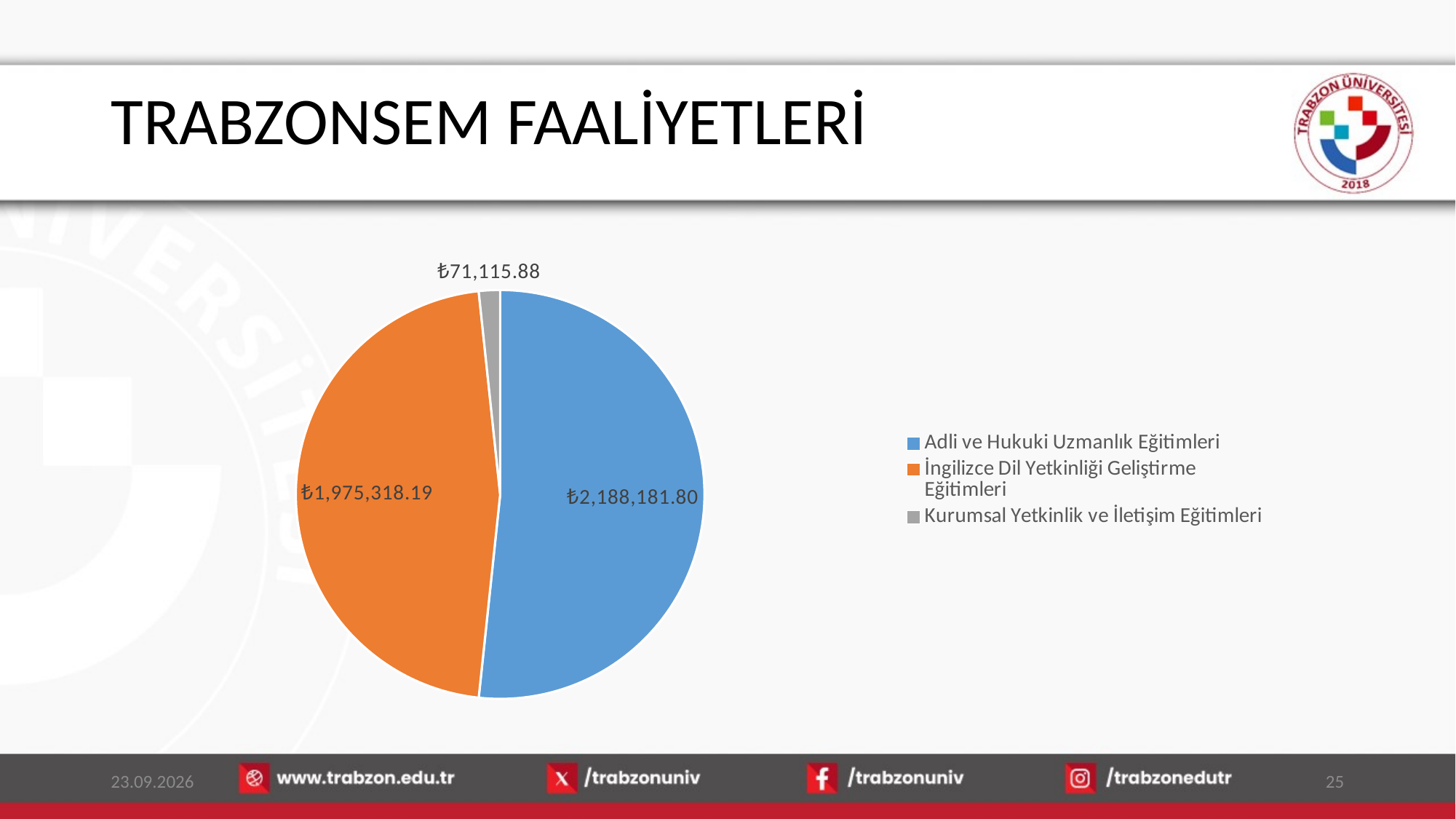
Which category has the largest slice of the pie? Adli ve Hukuki Uzmanlık Eğitimleri Which is larger, the value for Adli ve Hukuki Uzmanlık Eğitimleri or the value for İngilizce Dil Yetkinliği Geliştirme Eğitimleri? Adli ve Hukuki Uzmanlık Eğitimleri Which category has the smallest slice of the pie? Kurumsal Yetkinlik ve İletişim Eğitimleri What is the value for Kurumsal Yetkinlik ve İletişim Eğitimleri? ₺71,115.88 What is the difference between the values for İngilizce Dil Yetkinliği Geliştirme Eğitimleri and Kurumsal Yetkinlik ve İletişim Eğitimleri? ₺1,904,202.31 How many categories are shown in the pie chart? 3 What is the total of all three slices in the pie chart? ₺4,234,615.87 What is the value for Adli ve Hukuki Uzmanlık Eğitimleri? ₺2,188,181.80 What is the value for İngilizce Dil Yetkinliği Geliştirme Eğitimleri? ₺1,975,318.19 What is the difference between the values for Adli ve Hukuki Uzmanlık Eğitimleri and İngilizce Dil Yetkinliği Geliştirme Eğitimleri? ₺212,863.61 What kind of chart is shown on the slide? Pie chart What colour is the slice for Kurumsal Yetkinlik ve İletişim Eğitimleri? Gray